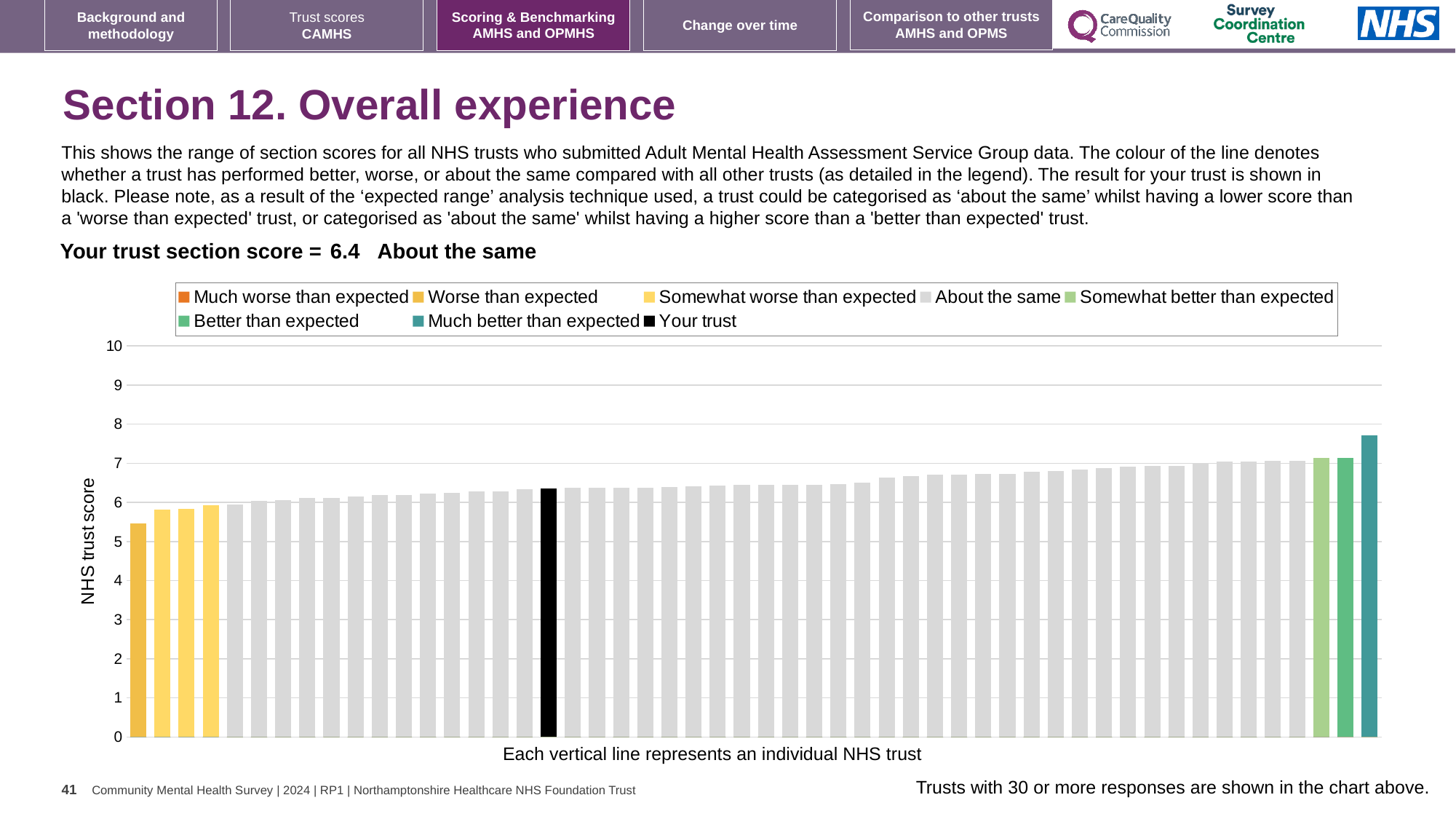
How many bars are coloured as 'Worse than expected' (yellow)? 1 Which legend category does the tallest bar on the chart belong to? Much better than expected What is the label on the vertical axis of the chart? NHS trust score What is the section score for your trust, as printed on the slide? 6.4 Which legend category does the shortest bar on the chart belong to? Worse than expected Do the bar values rise or fall from left to right along the x axis? rise Is the value of the black 'Your trust' bar greater or less than 6? greater Is the value of the shortest bar on the chart greater or less than 5? greater Is the value of the tallest bar (the teal 'Much better than expected' trust) greater or less than 7? greater How many entries does the chart legend list? 8 What kind of chart is shown on the slide? bar chart How many bars are coloured as 'Much better than expected' (teal)? 1